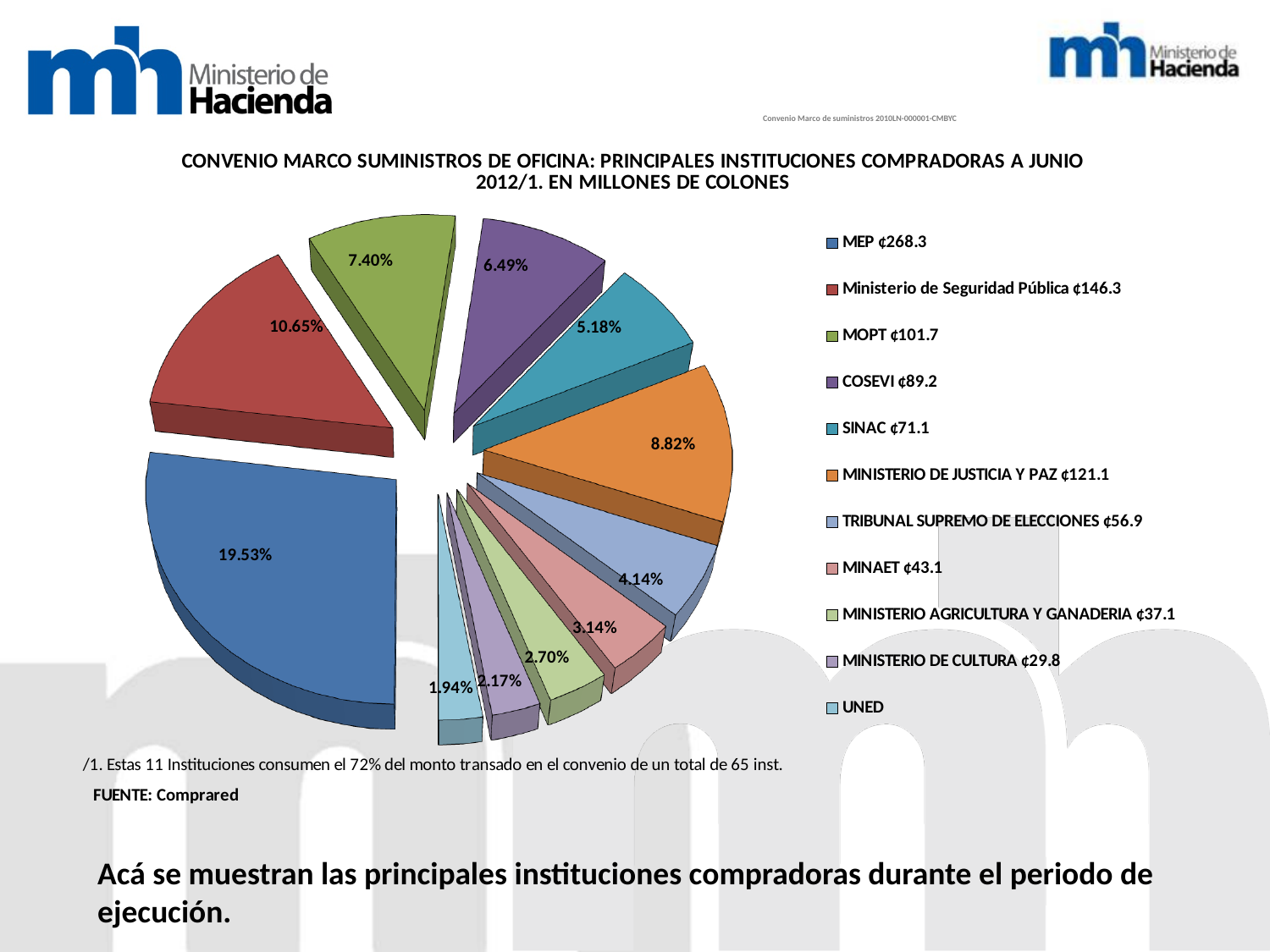
What amount in millions of colones is shown for MOPT in the legend? ¢101.7 What is the title of the chart? CONVENIO MARCO SUMINISTROS DE OFICINA: PRINCIPALES INSTITUCIONES COMPRADORAS A JUNIO 2012/1. EN MILLONES DE COLONES What percentage share does the MINISTERIO DE JUSTICIA Y PAZ slice have? 8.82% Which has a larger share of the pie, SINAC or TRIBUNAL SUPREMO DE ELECCIONES? SINAC What kind of chart is shown on the slide? pie chart What is the difference between the amounts for MEP (¢268.3) and Ministerio de Seguridad Pública (¢146.3)? ¢122.0 How many slices does the pie chart have? 11 What percentage share does the MEP slice have? 19.53% What amount in millions of colones is shown for COSEVI in the legend? ¢89.2 Which institution has the smallest slice of the pie? UNED Which institution has the largest slice of the pie? MEP What percentage share does the Ministerio de Seguridad Pública slice have? 10.65%